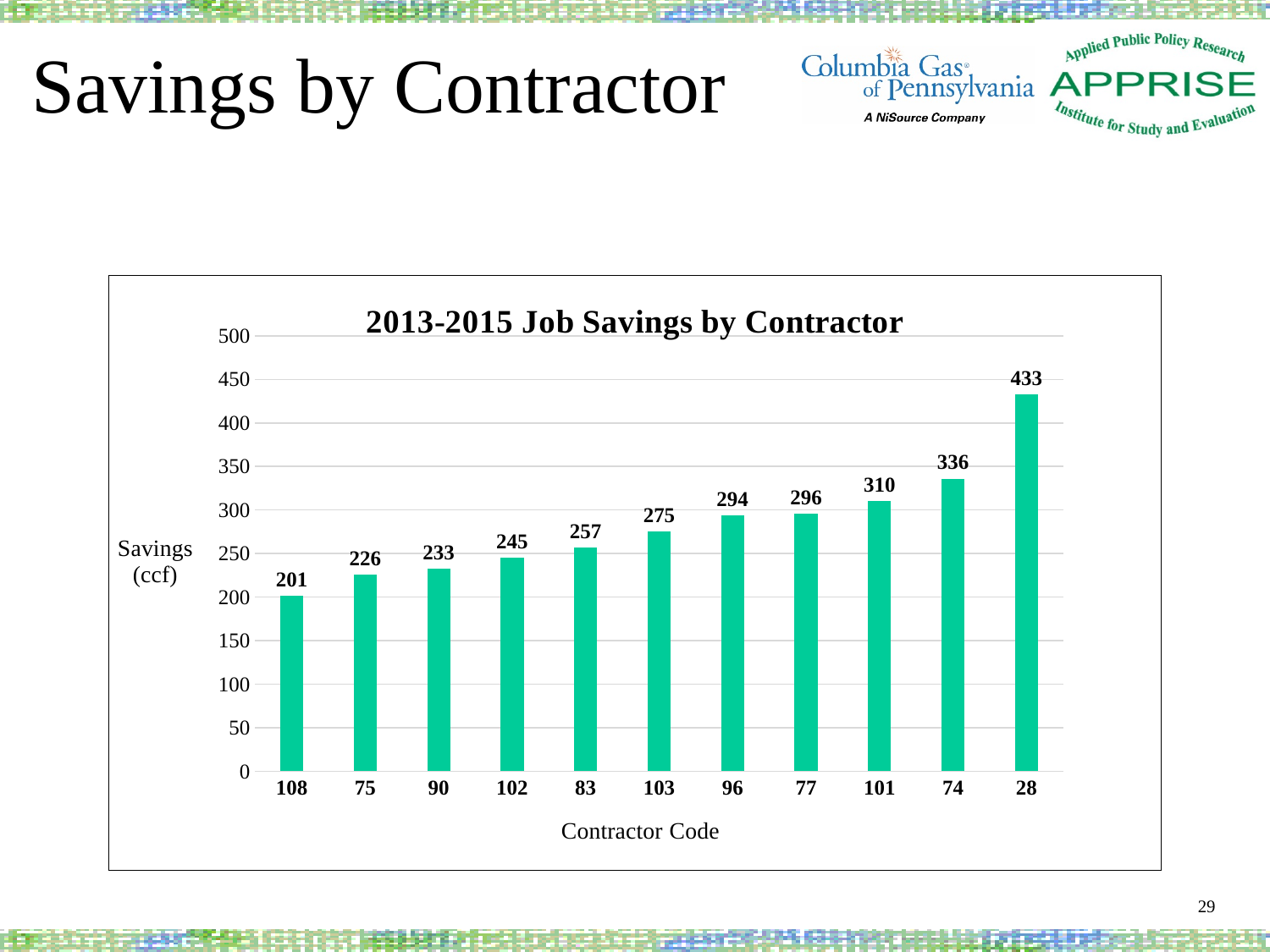
What is the difference in savings between contractor code 28 and contractor code 74? 97 What is the savings value for contractor code 108? 201 What kind of chart is shown on the slide? bar chart Which contractor code has the highest savings? 28 What is the title of the chart? 2013-2015 Job Savings by Contractor What is the savings value for contractor code 74? 336 Which contractor code has the lowest savings? 108 What is the savings value for contractor code 77? 296 Is the savings value for contractor code 83 greater or less than 300? less Which has higher savings, contractor code 90 or contractor code 101? 101 What is the difference in savings between contractor code 103 and contractor code 108? 74 How many contractor codes are shown in the chart? 11